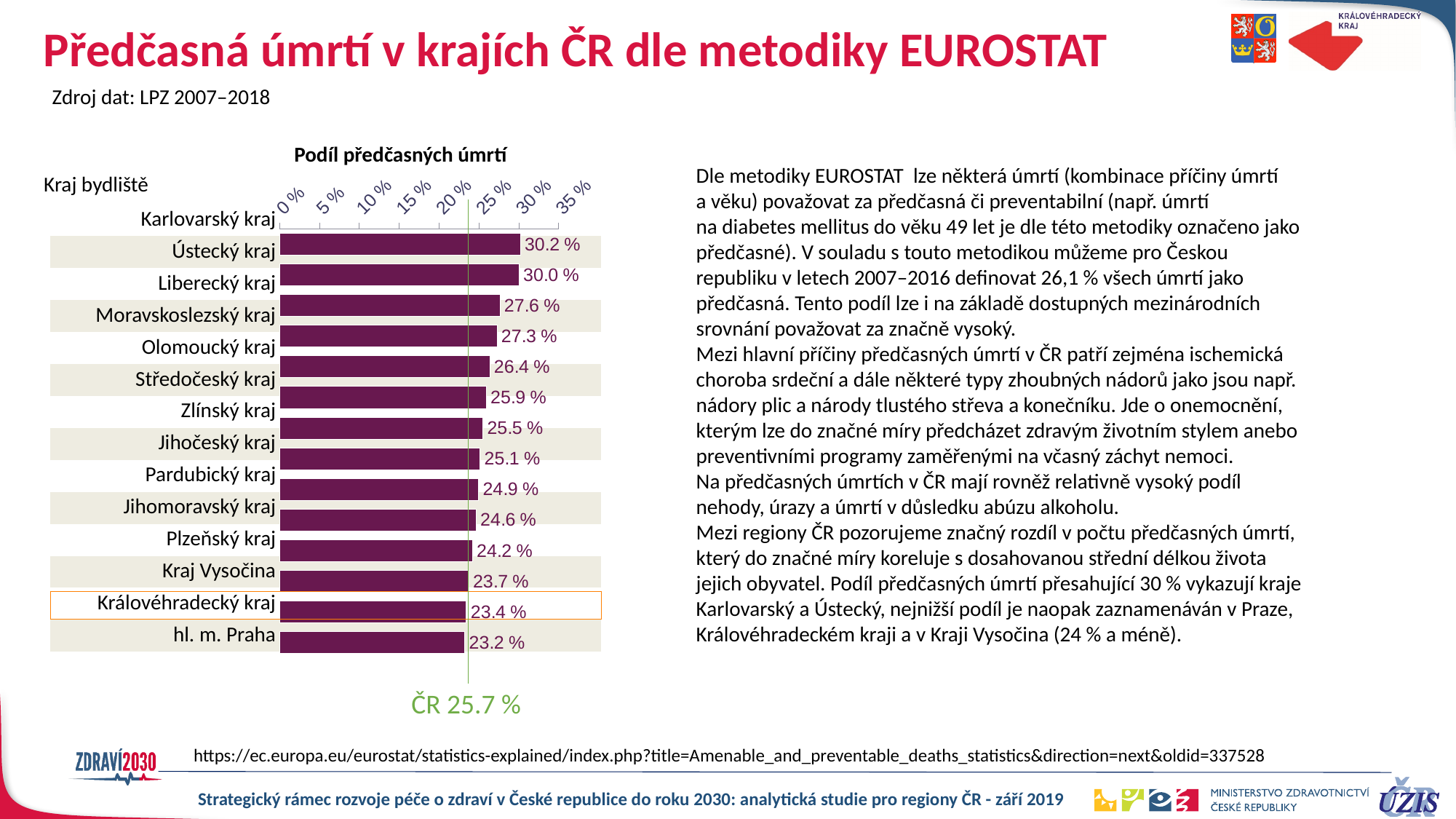
Which region has the lowest share of premature deaths? hl. m. Praha How many regions (kraje) are listed in the chart? 14 What type of chart is shown on the slide? bar chart Which region has the highest share of premature deaths? Karlovarský kraj Is the value for hl. m. Praha greater or less than 25 %? less What is the highest value shown in the chart? 30.2 % What is the title of the chart? Podíl předčasných úmrtí What is the value shown for the Czech Republic (ČR) as a whole? 25.7 % What is the lowest value shown in the chart? 23.2 % What is the share of premature deaths for Královéhradecký kraj (the highlighted row)? 23.4 % Do the bar values increase or decrease going from the top of the chart to the bottom? decrease What is the difference between the highest value (30.2 %) and the lowest value (23.2 %) in the chart? 7.0 %